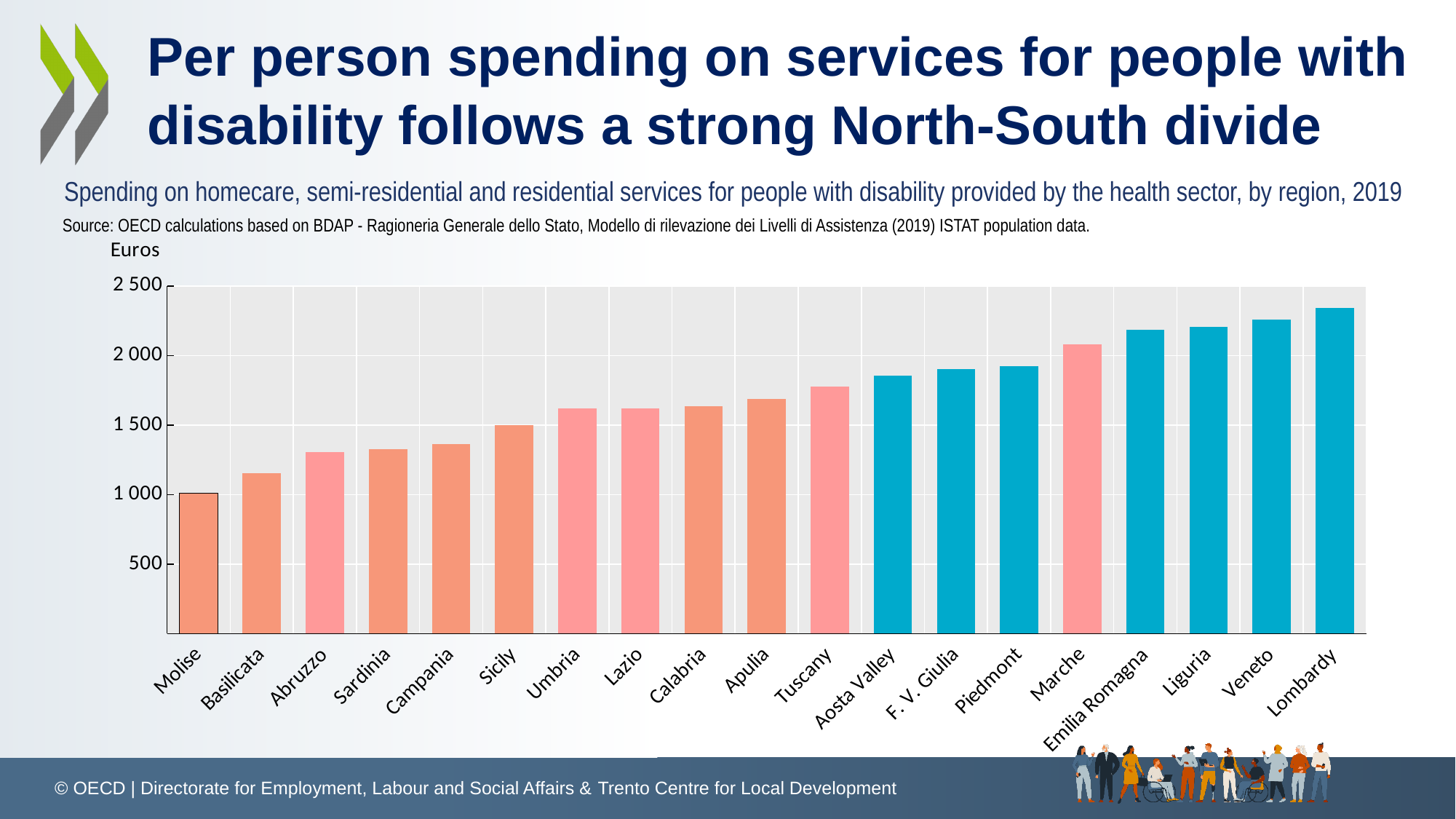
What kind of chart is shown on the slide? Bar chart Is the value for Basilicata greater or less than 1 000? greater What unit is shown on the vertical axis of the chart? Euros Which region has the highest per person spending? Lombardy Is the value for Abruzzo greater or less than 1 500? less Do the values rise or fall moving from left to right along the x axis? Rise Is the value for Umbria greater or less than 1 500? greater Which region has the lowest per person spending? Molise Which has the higher per person spending, Veneto or Tuscany? Veneto How many regions are shown on the chart? 19